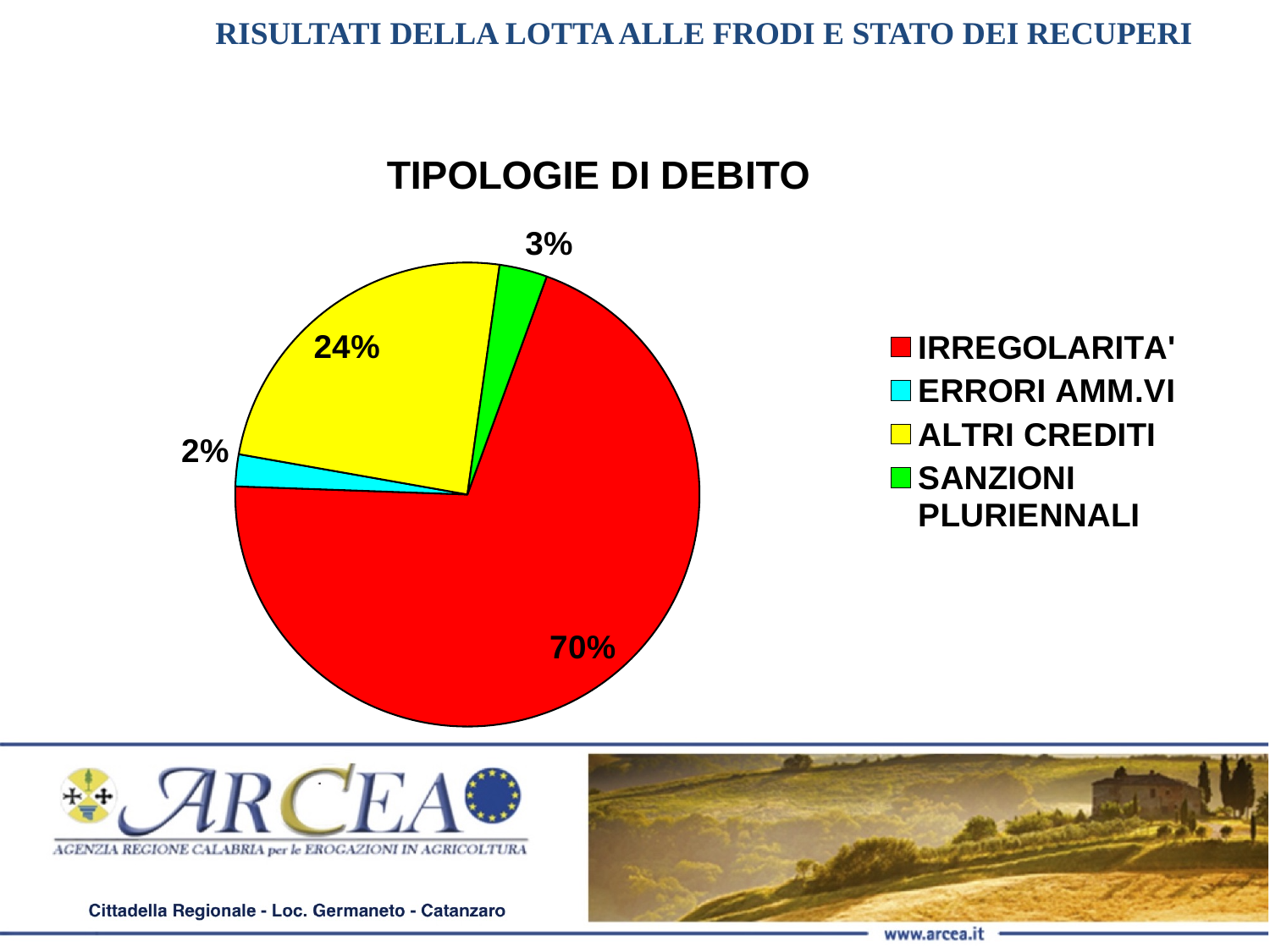
What is the difference between the shares of IRREGOLARITA' and ALTRI CREDITI? 46% What share of the pie does ALTRI CREDITI represent? 24% What colour is the slice for ALTRI CREDITI? yellow What type of chart is shown on the slide? pie chart How many categories does the legend list? 4 Which category has the largest slice of the pie? IRREGOLARITA' What share of the pie does SANZIONI PLURIENNALI represent? 3% Which is larger, the share for SANZIONI PLURIENNALI or the share for ERRORI AMM.VI? SANZIONI PLURIENNALI What share of the pie does IRREGOLARITA' represent? 70% Which category has the smallest slice of the pie? ERRORI AMM.VI What is the title of the chart? TIPOLOGIE DI DEBITO